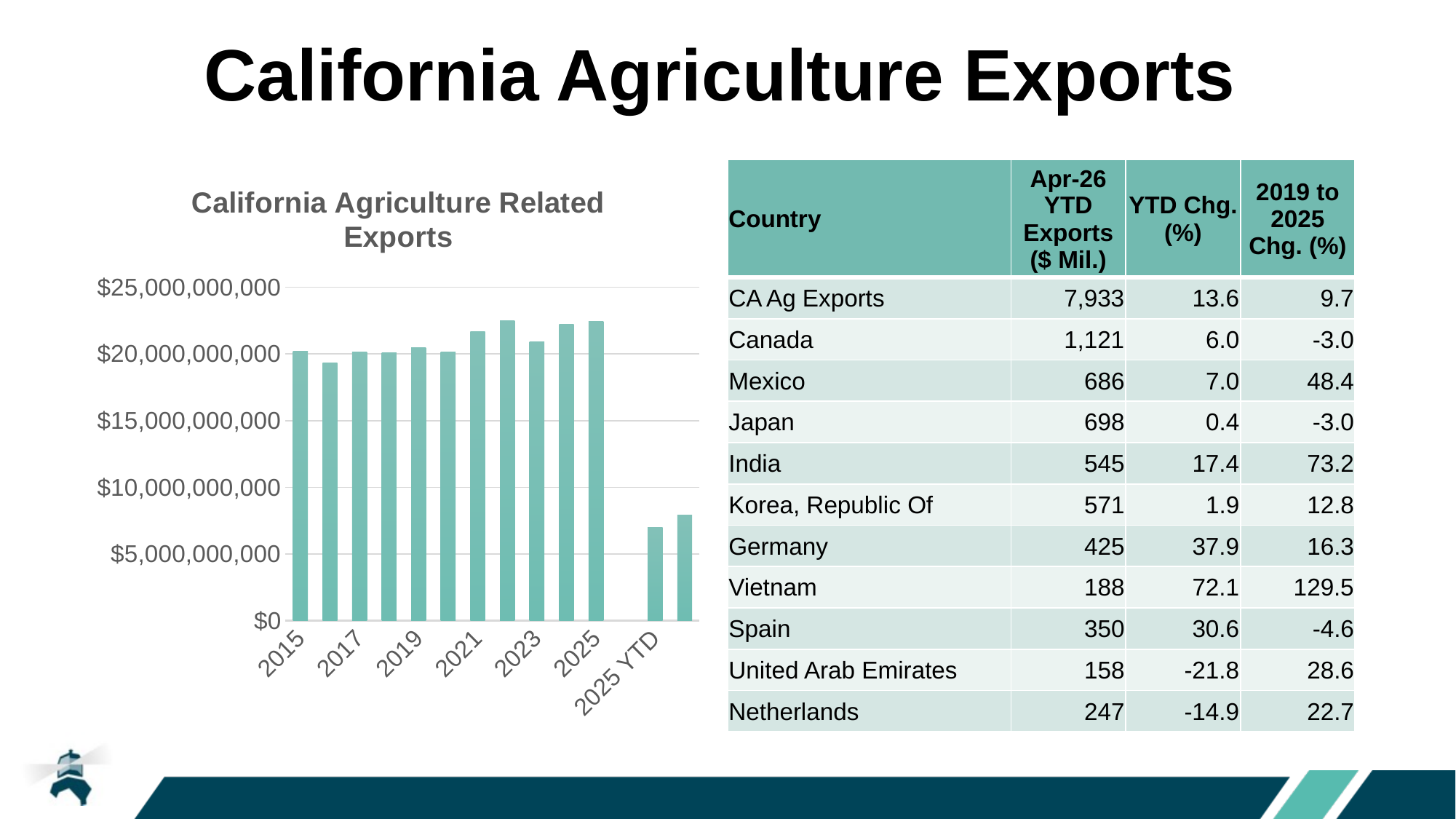
Which labelled category on the x axis has the lowest bar? 2025 YTD Is the value for 2025 YTD greater or less than $5,000,000,000? greater Is the value for 2021 greater or less than $20,000,000,000? greater Which is larger, the value for 2015 or the value for 2025? 2025 Is the value for 2025 greater or less than $25,000,000,000? less Do the full-year values generally rise or fall from 2015 to 2025? rise What is the highest value shown on the chart's vertical axis? $25,000,000,000 Which is larger, the value for 2019 or the value for 2025 YTD? 2019 What is the title of the chart on the slide? California Agriculture Related Exports What kind of chart is shown on the slide? bar chart